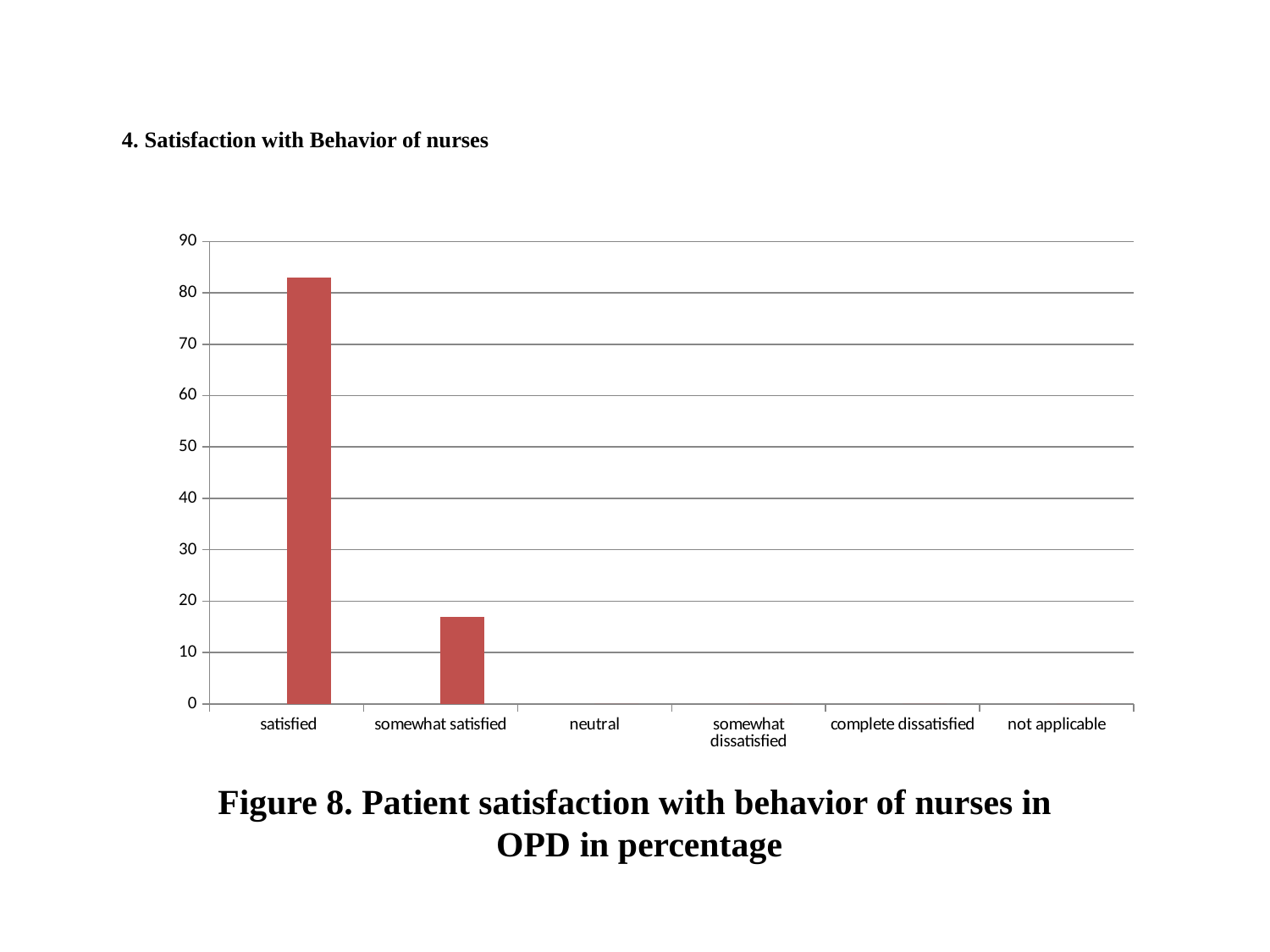
Is the value for 'satisfied' greater or less than 80? greater Do the bar values rise or fall moving from 'satisfied' to 'somewhat satisfied' along the x axis? fall What is the highest tick value shown on the y axis? 90 What is the figure caption below the chart? Figure 8. Patient satisfaction with behavior of nurses in OPD in percentage What type of chart is shown on the slide? bar chart Which category has the highest value in the chart? satisfied How many categories in the chart have a visible bar? 2 Which is larger, the value for 'satisfied' or the value for 'somewhat satisfied'? satisfied Is the value for 'somewhat satisfied' greater or less than 10? greater How many categories are shown on the x axis of the chart? 6 Is the value for 'somewhat satisfied' greater or less than 20? less